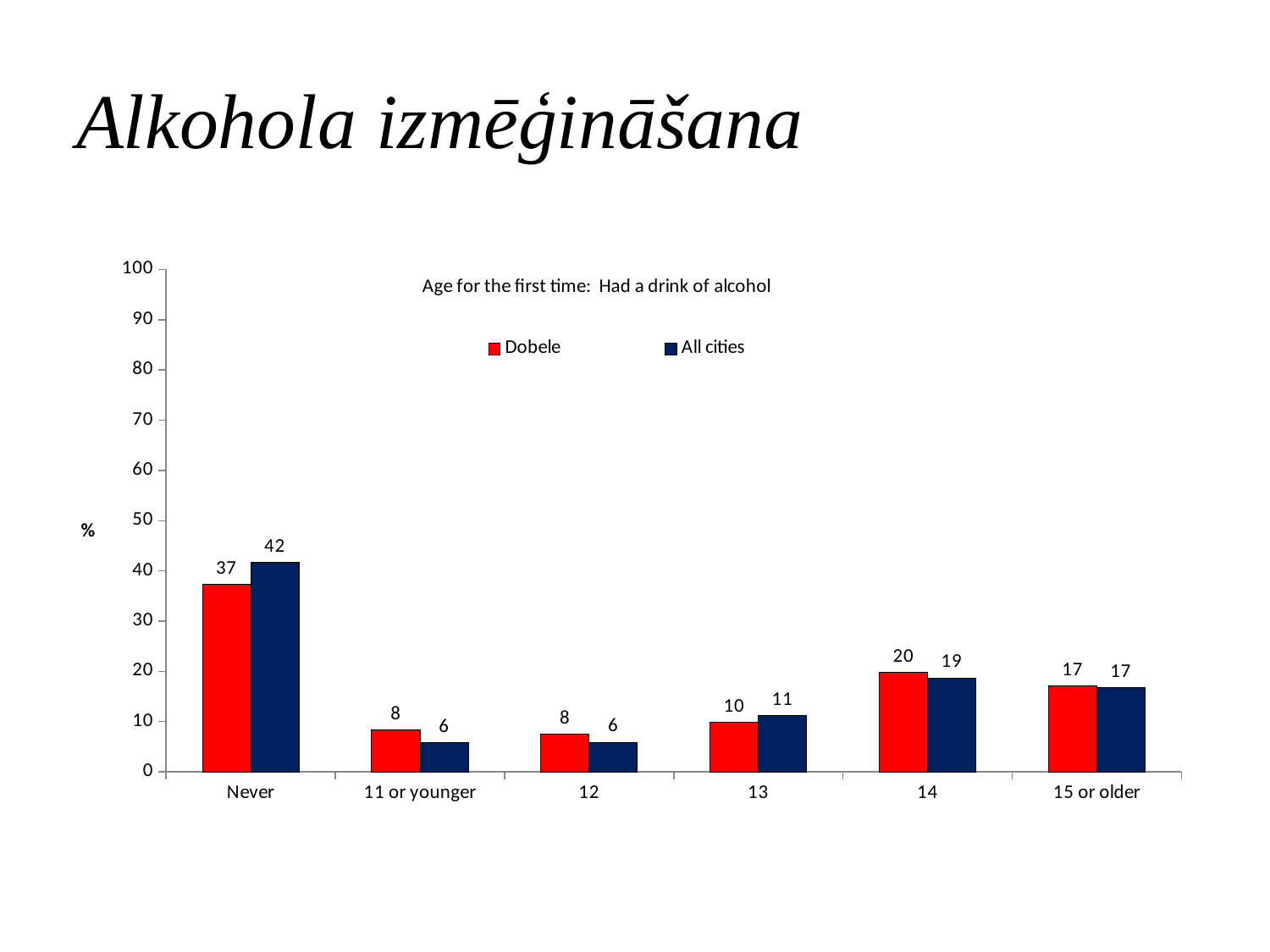
Which is larger at age 12, Dobele or All cities? Dobele What is the difference between All cities and Dobele in the Never category? 5 What is the value for Dobele at age 14? 20 How many series does the legend list? 2 What is the title of the chart? Age for the first time: Had a drink of alcohol What kind of chart is shown on the slide? Bar chart What is the value for Dobele in the Never category? 37 Is the value for All cities in the Never category greater or less than 40? greater Which category has the highest value for Dobele? Never How many age categories are shown on the x axis? 6 What is the value for All cities at age 13? 11 What is the value for All cities in the Never category? 42